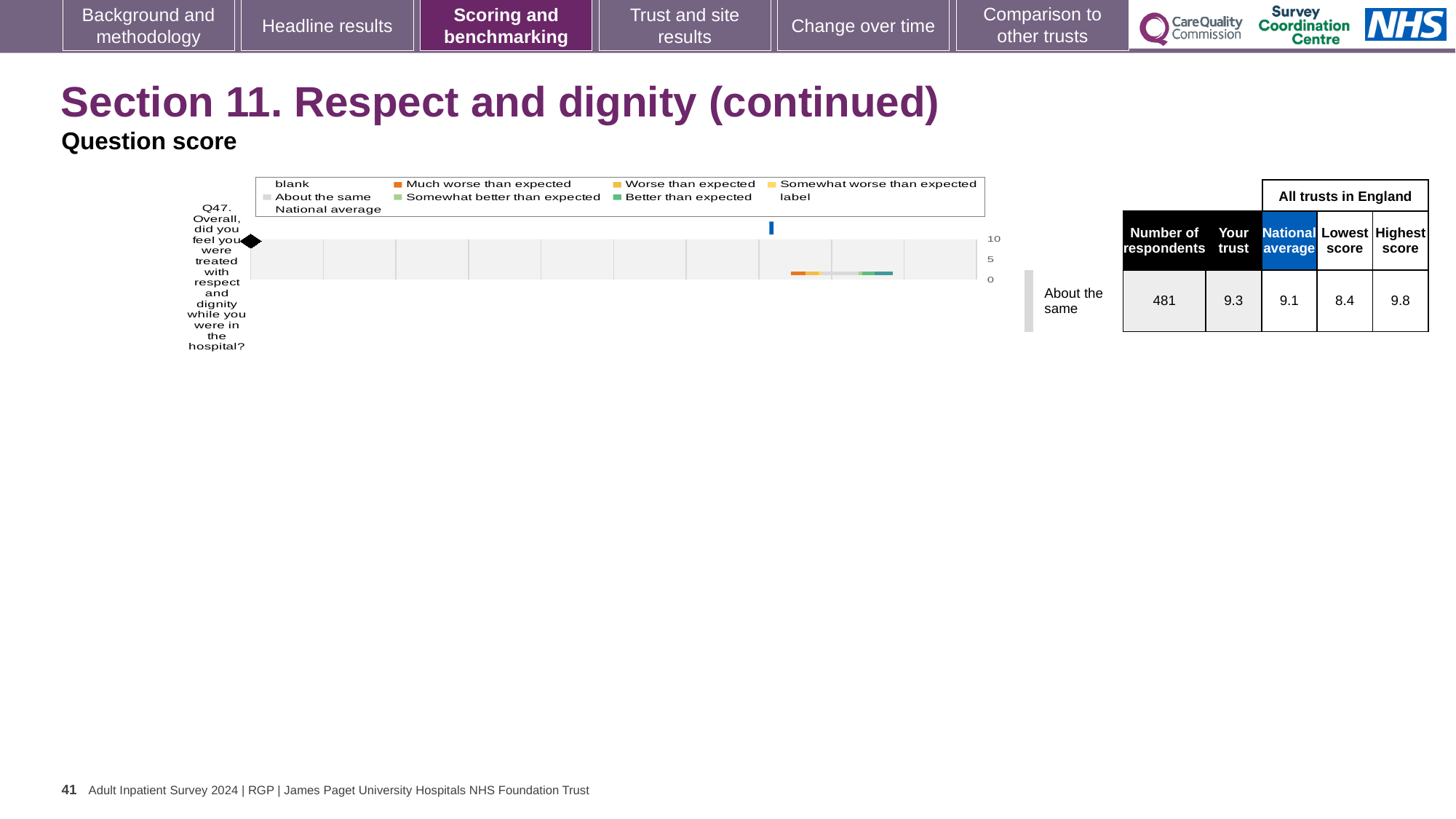
Which is larger for Q47, the 'Your trust' score or the national average? Your trust What is the national average score shown for Q47? 9.1 What benchmarking category is the trust's Q47 score placed in? About the same What is the highest tick value shown on the chart's axis? 10 What is the lowest score among all trusts in England shown for Q47? 8.4 Is the 'Your trust' score for Q47 greater or less than 5? greater How many respondents are shown for Q47? 481 What is the highest score among all trusts in England shown for Q47? 9.8 Which question is plotted on the chart? Q47. Overall, did you feel you were treated with respect and dignity while you were in the hospital? What is the 'Your trust' score shown for Q47? 9.3 What is the difference between the highest score and the lowest score shown for Q47? 1.4 What is the difference between the 'Your trust' score and the national average for Q47? 0.2